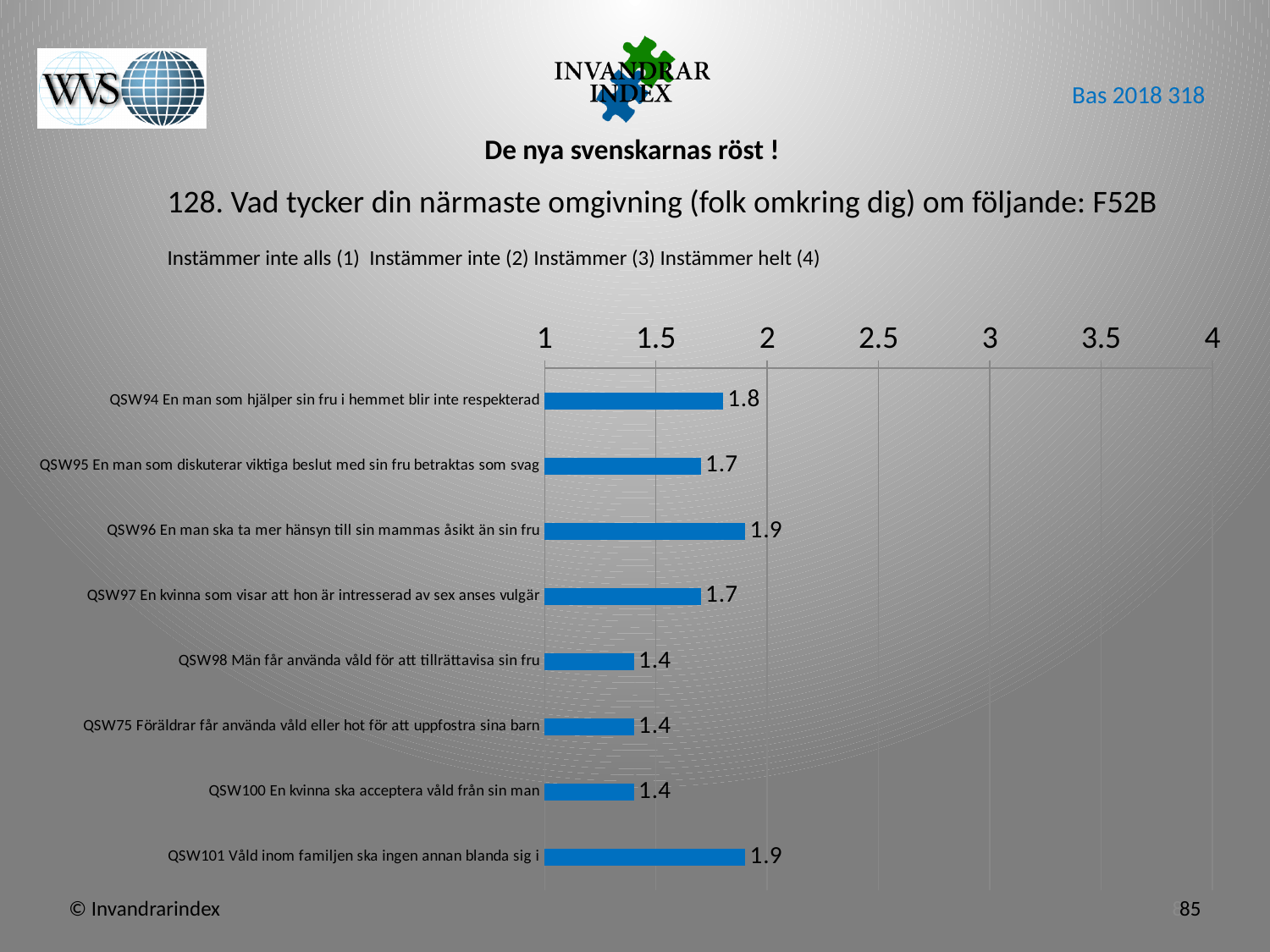
Which has a larger value, QSW94 or QSW98? QSW94 Which has a larger value, QSW100 or QSW101? QSW101 What kind of chart is shown on the slide? Bar chart What is the value for QSW94 En man som hjälper sin fru i hemmet blir inte respekterad? 1.8 What is the difference between the values for QSW94 and QSW75? 0.4 What is the difference between the values for QSW96 and QSW98? 0.5 What is the value for QSW95 En man som diskuterar viktiga beslut med sin fru betraktas som svag? 1.7 What is the value for QSW101 Våld inom familjen ska ingen annan blanda sig i? 1.9 What is the value for QSW98 Män får använda våld för att tillrättavisa sin fru? 1.4 Is the value for QSW96 greater or less than 2? less How many categories are shown in the chart? 8 What is the value for QSW100 En kvinna ska acceptera våld från sin man? 1.4